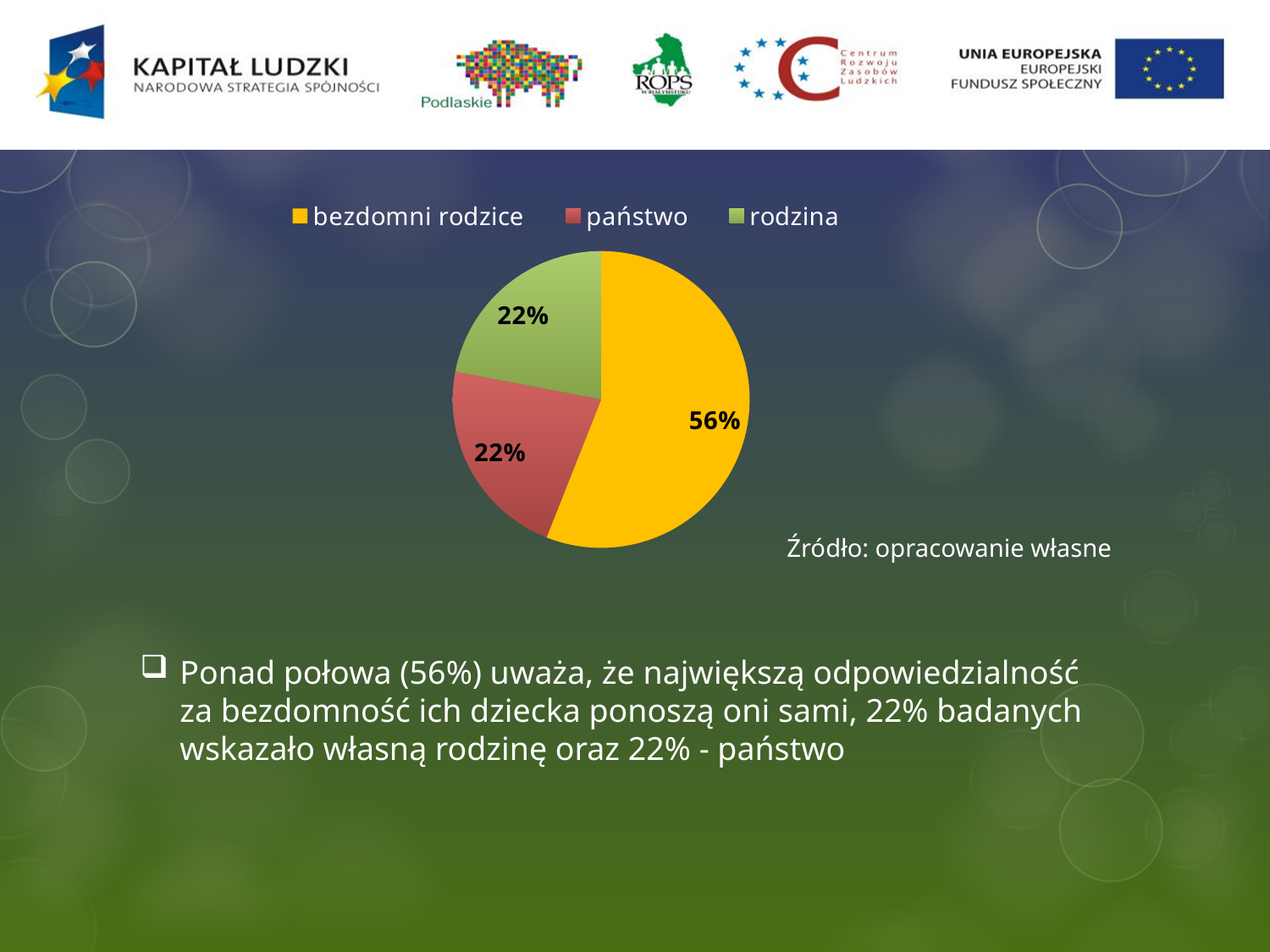
What colour is the slice for "państwo"? red What colour is the slice for "rodzina"? green What is the difference between the share for "bezdomni rodzice" and the share for "państwo"? 34% How many entries does the legend list? 3 Which category has the largest slice of the pie? bezdomni rodzice Is the share for "bezdomni rodzice" greater or less than 50%? greater How many slices does the pie chart have? 3 What kind of chart is shown on the slide? pie chart What share of the pie does "rodzina" have? 22% Which is larger, the share for "bezdomni rodzice" or the share for "rodzina"? bezdomni rodzice What share of the pie does "państwo" have? 22% What share of the pie does "bezdomni rodzice" have? 56%